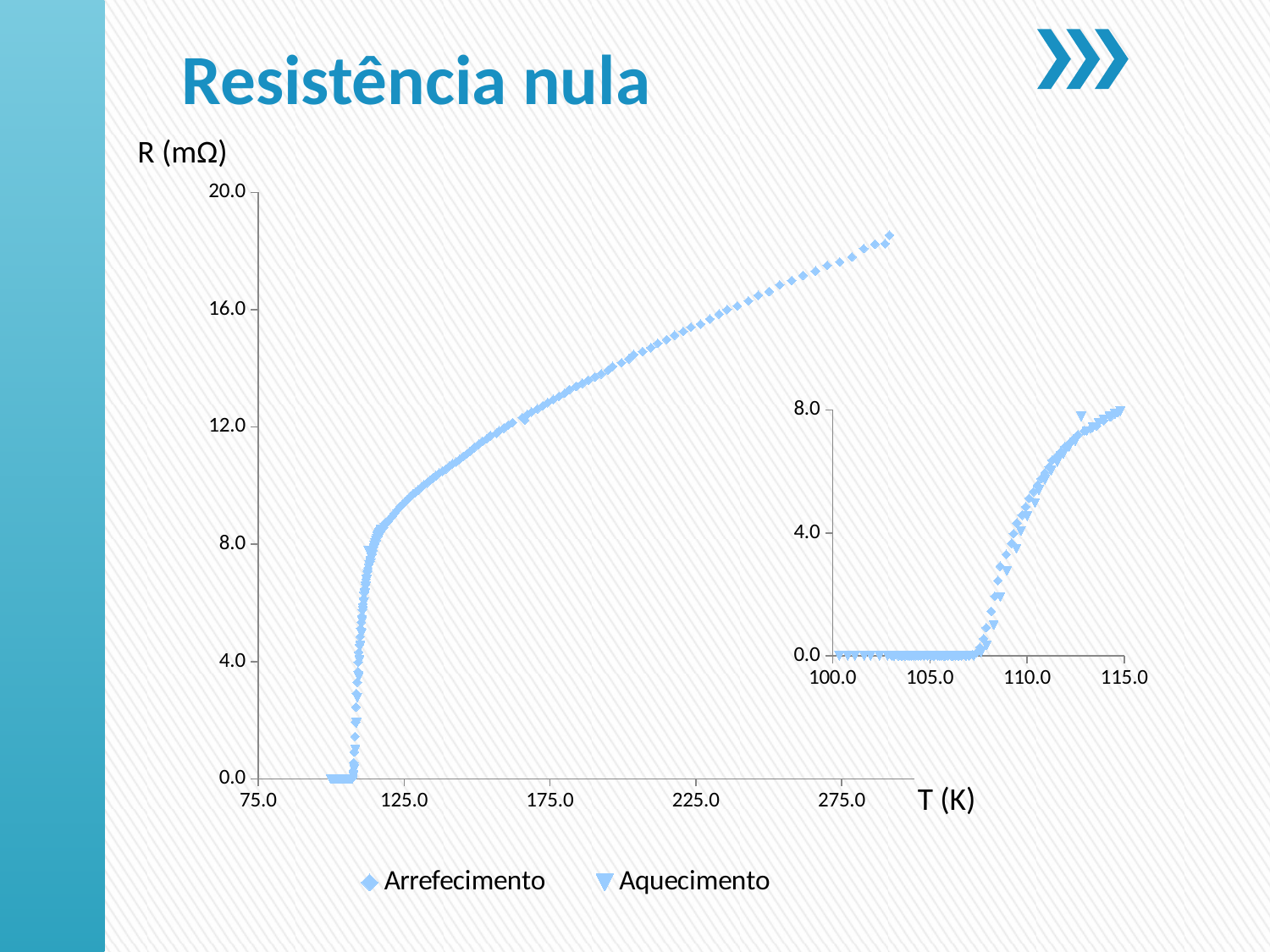
In the main chart, is the resistance at 275.0 K greater or less than 16.0? greater How many series does the legend list? 2 What is the highest tick value shown on the vertical axis of the main chart? 20.0 In the inset chart (lower right), is the resistance at 115.0 K greater or less than 4.0? greater What is the label of the vertical axis of the main chart? R (mΩ) In the main chart, is the resistance at 225.0 K greater or less than 12.0? greater What kind of chart is the main chart on the slide? scatter chart How many tick labels are shown on the horizontal axis of the main chart? 5 In the main chart, does the resistance rise or fall as temperature increases above about 125 K? rise What are the two series named in the legend? Arrefecimento and Aquecimento